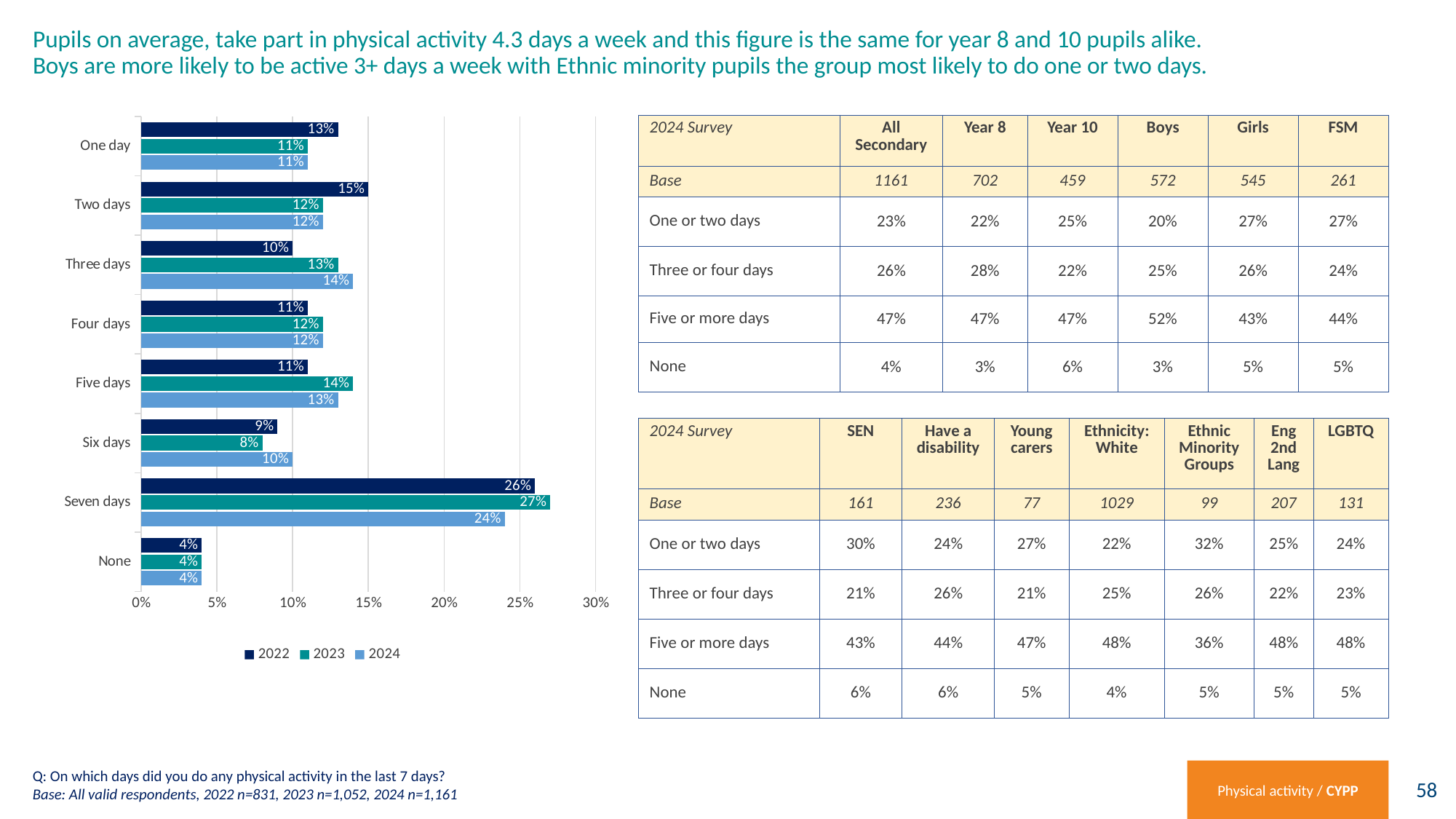
Which is larger for Three days, the 2022 value or the 2024 value? 2024 Is the 2022 value for Seven days greater or less than 25%? greater What is the 2023 value for Five days? 14% What type of chart is shown on the slide? bar chart Which category has the lowest 2024 value? None What is the difference between the 2023 and 2024 values for Seven days? 3% How many series does the chart legend list? 3 What is the 2022 value for Two days? 15% Which category has the highest 2023 value? Seven days Which series is shown in the darkest blue colour in the chart? 2022 How many categories are shown on the chart's vertical axis? 8 What is the 2024 value for Seven days? 24%